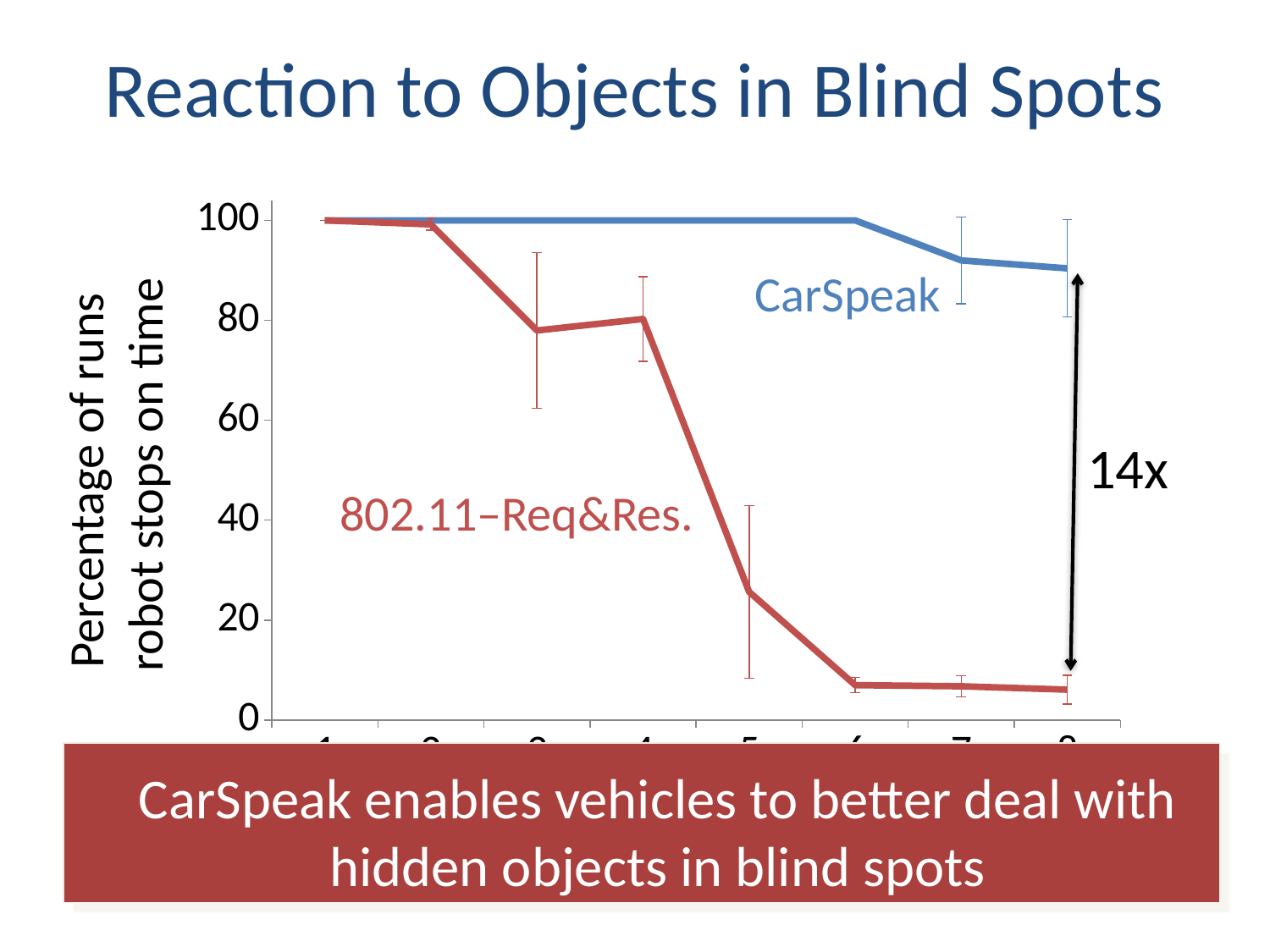
What factor is written next to the arrow between the two series at the right of the chart? 14x Is the value of the CarSpeak series at the last point on the x axis greater or less than 80? greater What kind of chart is shown on the slide? line chart What is the label of the y axis? Percentage of runs robot stops on time Is the value of the 802.11–Req&Res. series at the last point on the x axis greater or less than 20? less Does the 802.11–Req&Res. series rise or fall along the x axis? fall What is the value of the 802.11–Req&Res. series at the first point on the x axis? 100 What is the title of the slide's chart? Reaction to Objects in Blind Spots At the last point on the x axis, which series has the higher value, CarSpeak or 802.11–Req&Res.? CarSpeak How many data series are plotted on the chart? 2 What is the value of the CarSpeak series at the first point on the x axis? 100 How many points are plotted for the 802.11–Req&Res. series? 8